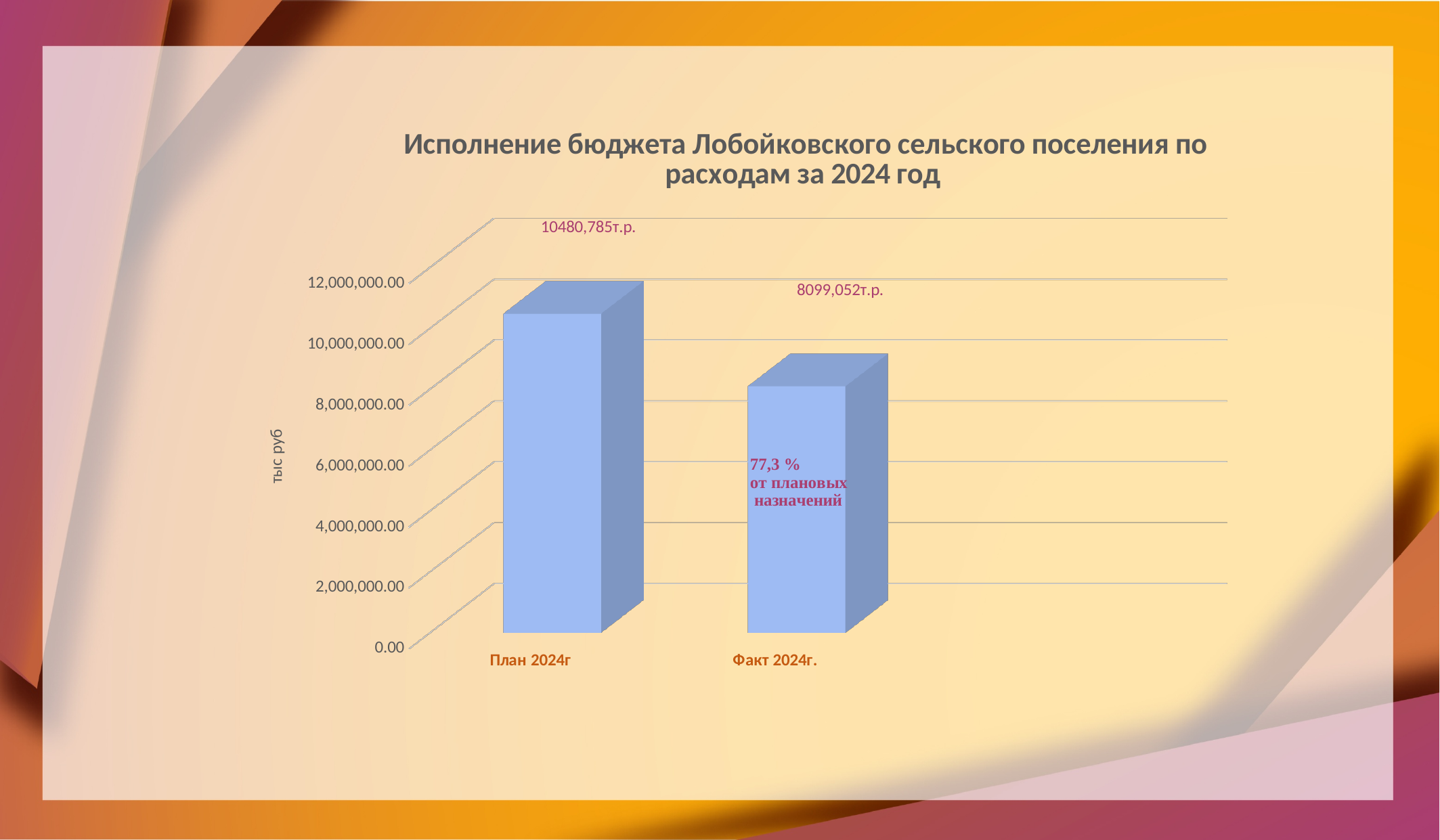
How many categories are shown on the chart? 2 What percentage of planned appropriations does the Факт 2024г. bar represent, according to the annotation on the chart? 77,3 % What is the difference between the labelled values for План 2024г and Факт 2024г.? 2381,733т.р. What value is labelled for Факт 2024г.? 8099,052т.р. Which category has the highest value on the chart? План 2024г Which category has the lowest value on the chart? Факт 2024г. Which category has the higher value, План 2024г or Факт 2024г.? План 2024г What kind of chart is shown on the slide? bar chart Is the value for Факт 2024г. greater or less than 10,000,000.00? less What is the label on the vertical axis of the chart? тыс руб What value is labelled for План 2024г? 10480,785т.р. Is the value for План 2024г greater or less than 10,000,000.00? greater